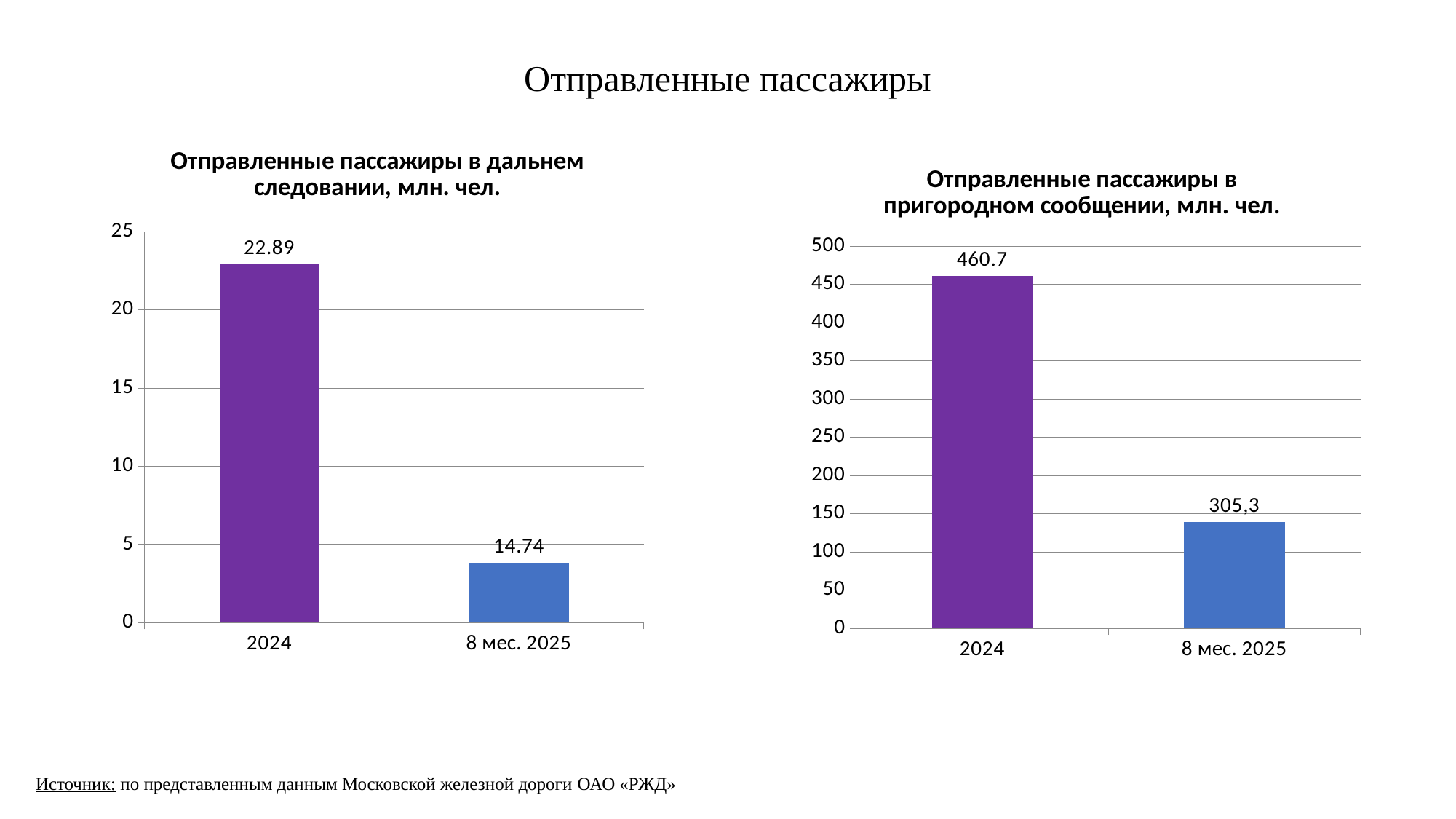
What is the title of the left chart? Отправленные пассажиры в дальнем следовании, млн. чел. In the right chart, what is the difference between the 2024 value and the 8 мес. 2025 value? 155.4 In the right chart (Отправленные пассажиры в пригородном сообщении), what is the value for 8 мес. 2025? 305,3 In the left chart, what is the difference between the 2024 value and the 8 мес. 2025 value? 8.15 In the right chart, which category has the lowest value? 8 мес. 2025 In the left chart, which category has the highest value? 2024 What type of chart is the right chart (Отправленные пассажиры в пригородном сообщении)? Bar chart In the left chart (Отправленные пассажиры в дальнем следовании), what is the value for 2024? 22.89 In the left chart (Отправленные пассажиры в дальнем следовании), what is the value for 8 мес. 2025? 14.74 How many categories are shown on the x axis of the left chart? 2 In the right chart (Отправленные пассажиры в пригородном сообщении), what is the value for 2024? 460.7 In the right chart, which is larger: the value for 2024 or the value for 8 мес. 2025? 2024